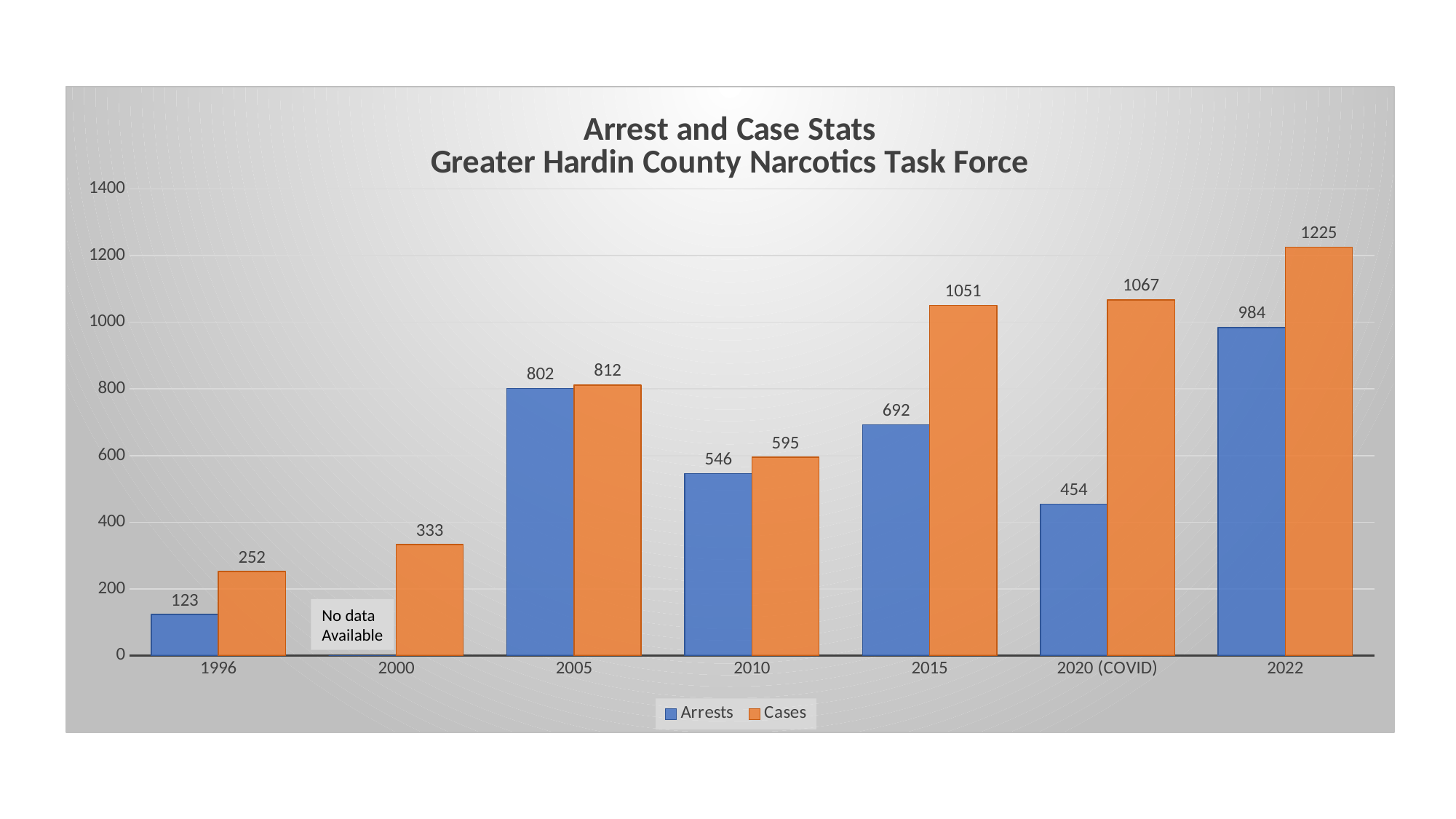
What is the number of Arrests in 2015? 692 Which is larger, Arrests in 2005 or Arrests in 2022? Arrests in 2022 How many series does the legend list? 2 Which year has the lowest number of Arrests among those with data shown? 1996 What is the difference between Cases and Arrests in 2010? 49 What is the number of Cases in 2022? 1225 Is the value for Cases in 2015 greater or less than 1000? greater What does the label on the 2000 Arrests bar say? No data Available How many year categories are shown on the x axis? 7 What is the number of Arrests in 2020 (COVID)? 454 What kind of chart is shown on the slide? Bar chart Which year has the highest number of Cases? 2022